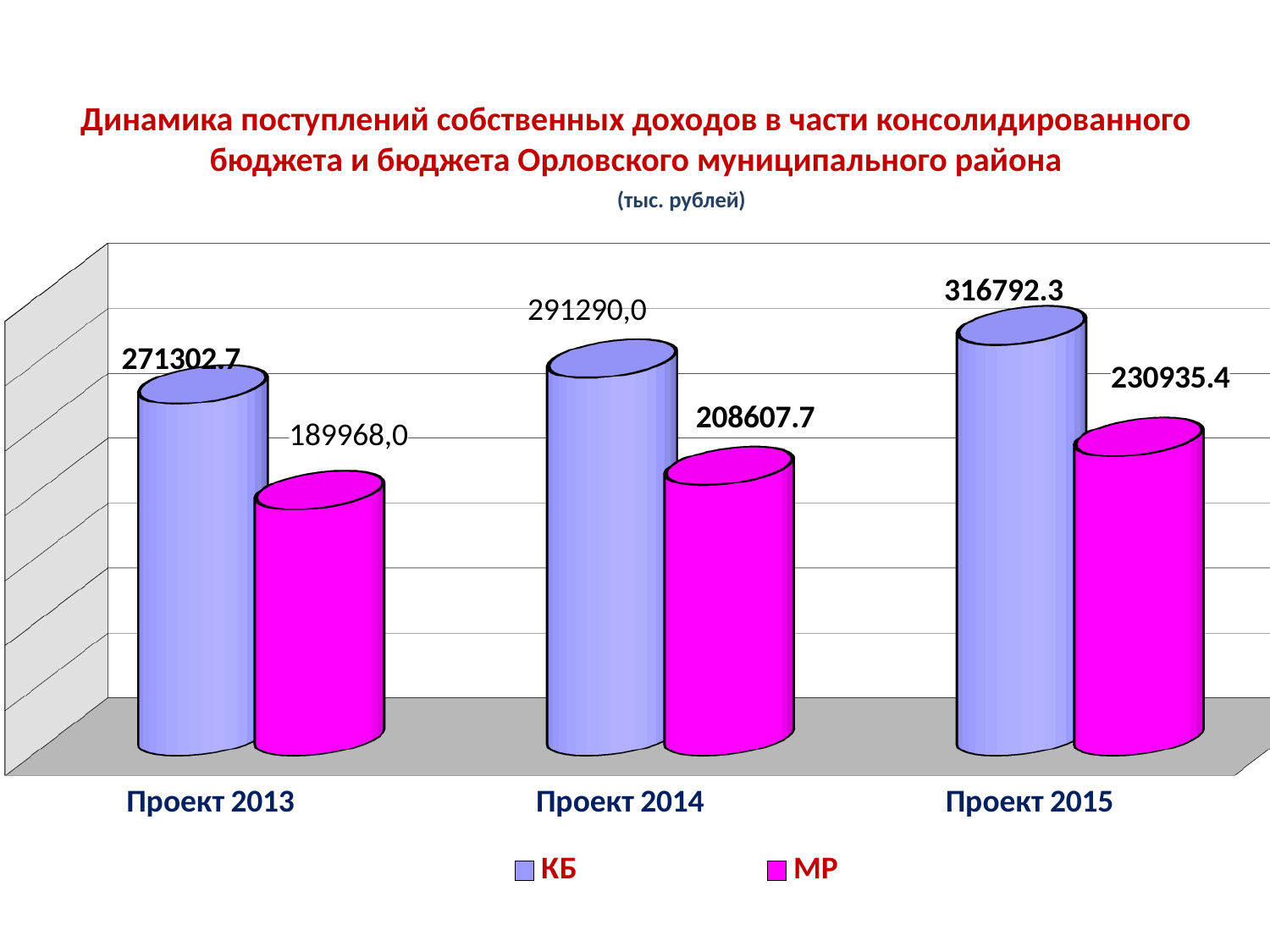
In which category is the КБ value highest? Проект 2015 What is the value for КБ in Проект 2013? 271302.7 What is the value for КБ in Проект 2015? 316792.3 What is the difference between КБ and МР in Проект 2015? 85856.9 Which is larger in Проект 2014: КБ or МР? КБ Do the МР values rise or fall from Проект 2013 to Проект 2015? Rise What kind of chart is shown on the slide? Bar chart What is the value for МР in Проект 2013? 189968,0 How many series does the legend list? 2 How many categories are shown on the x axis? 3 What is the value for МР in Проект 2014? 208607.7 In which category is the МР value lowest? Проект 2013